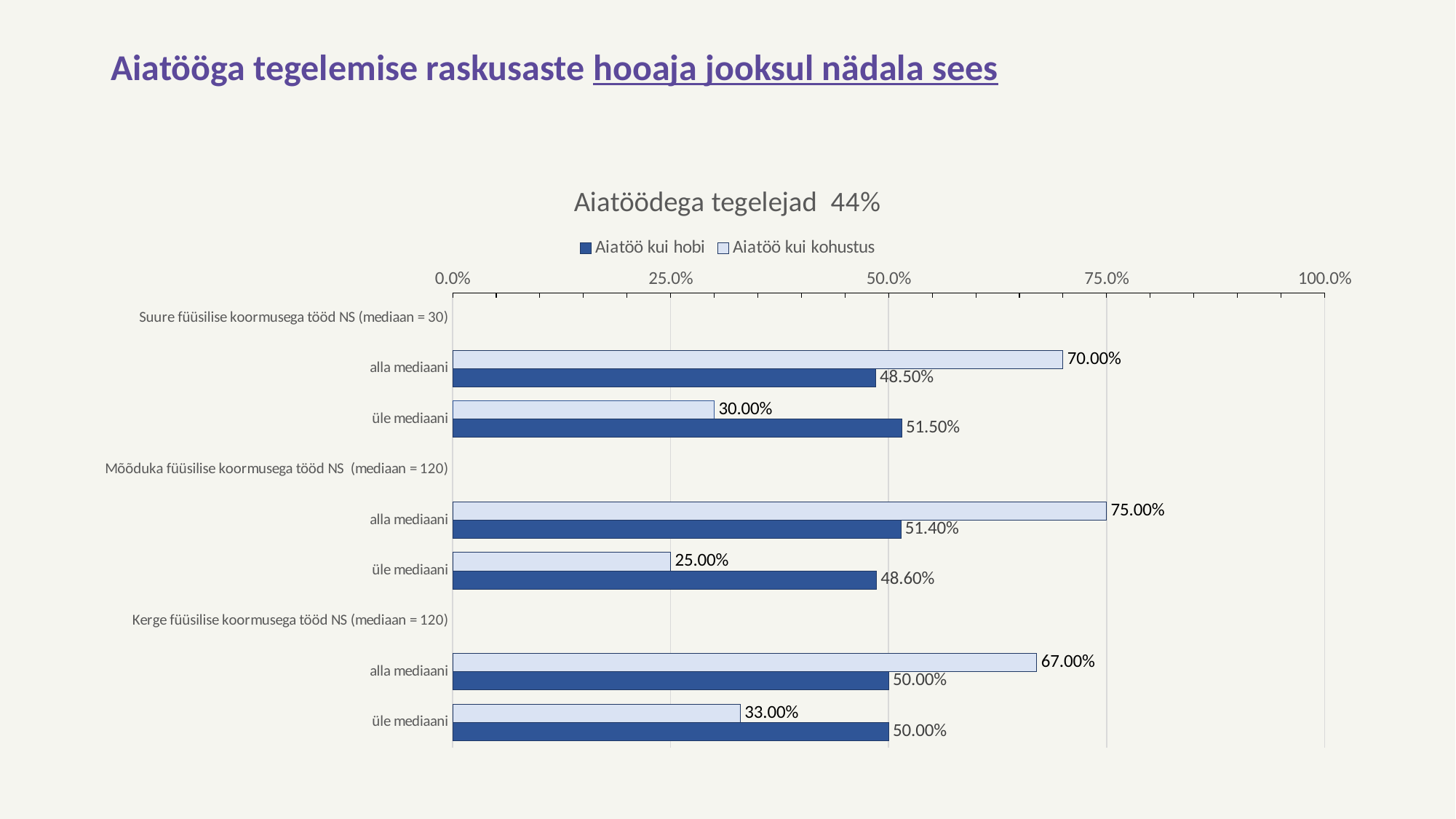
What type of chart is shown on the slide? bar chart For 'üle mediaani' under 'Kerge füüsilise koormusega tööd NS (mediaan = 120)', which is larger: 'Aiatöö kui hobi' or 'Aiatöö kui kohustus'? Aiatöö kui hobi How many series does the legend list? 2 What is the value of 'Aiatöö kui kohustus' for 'üle mediaani' under 'Mõõduka füüsilise koormusega tööd NS (mediaan = 120)'? 25.00% What is the value of 'Aiatöö kui kohustus' for 'alla mediaani' under 'Suure füüsilise koormusega tööd NS (mediaan = 30)'? 70.00% What is the value of 'Aiatöö kui hobi' for 'üle mediaani' under 'Suure füüsilise koormusega tööd NS (mediaan = 30)'? 51.50% Which bar has the highest value in the chart? Aiatöö kui kohustus, alla mediaani under Mõõduka füüsilise koormusega tööd NS (mediaan = 120) Which bar has the lowest value in the chart? Aiatöö kui kohustus, üle mediaani under Mõõduka füüsilise koormusega tööd NS (mediaan = 120) What is the value of 'Aiatöö kui hobi' for 'alla mediaani' under 'Kerge füüsilise koormusega tööd NS (mediaan = 120)'? 50.00% Is the value of 'Aiatöö kui kohustus' for 'alla mediaani' under 'Kerge füüsilise koormusega tööd NS (mediaan = 120)' greater or less than 50.0%? greater What is the title of the chart? Aiatöödega tegelejad 44% What is the difference between 'Aiatöö kui kohustus' and 'Aiatöö kui hobi' for 'alla mediaani' under 'Suure füüsilise koormusega tööd NS (mediaan = 30)'? 21.50%